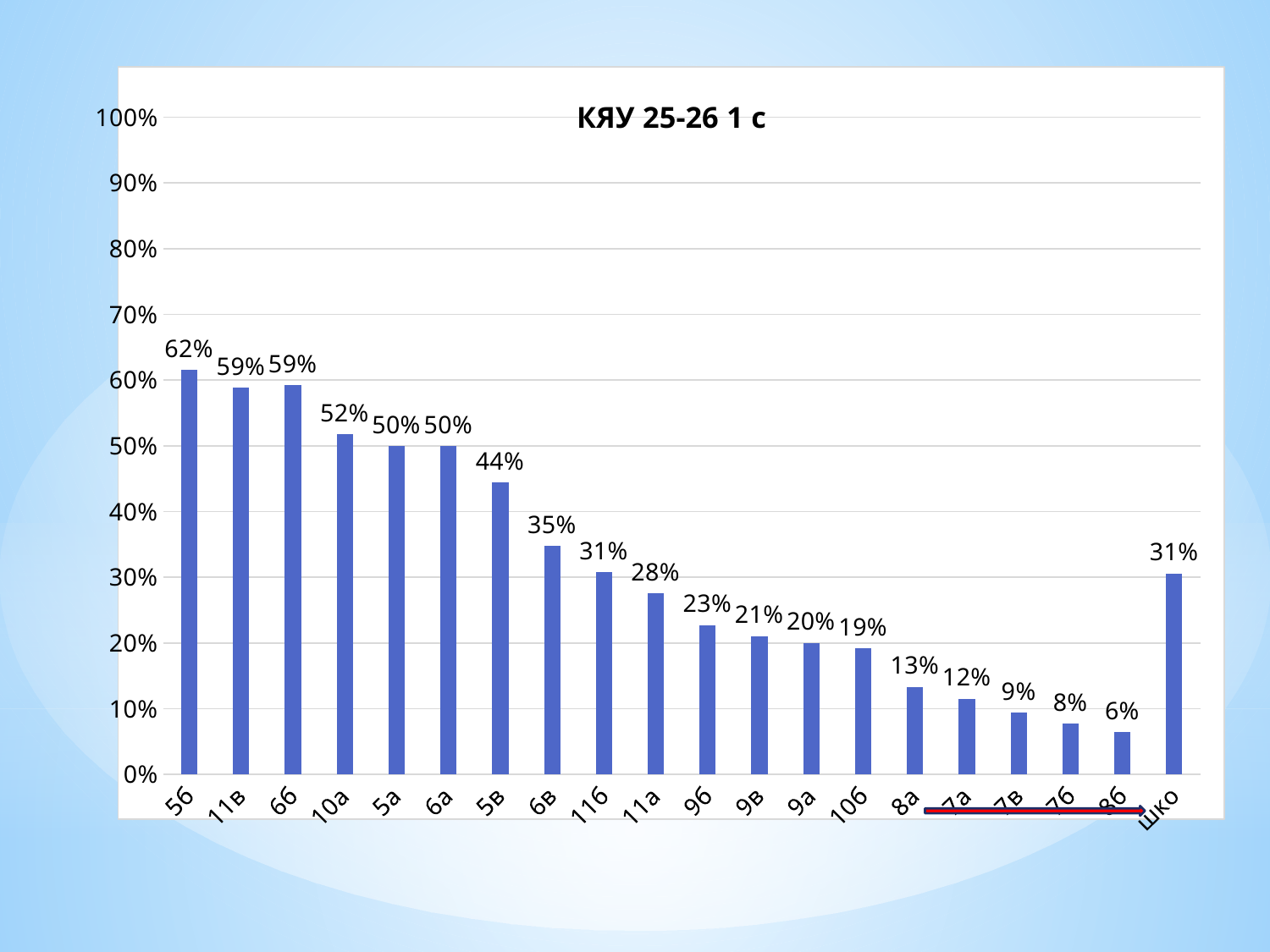
What is the title of the chart? КЯУ 25-26 1 с What is the value for шко? 31% What is the difference between the values for 10а and 6в? 17% Which is larger, the value for 9б or the value for 8а? 9б What is the value for 5в? 44% Is the value for 11а greater or less than 30%? less What kind of chart is shown on the slide? bar chart Which category has the highest value? 5б Which category has the lowest value? 8б How many bars are shown in the chart? 20 What is the value for 10б? 19% What is the value for 5б? 62%